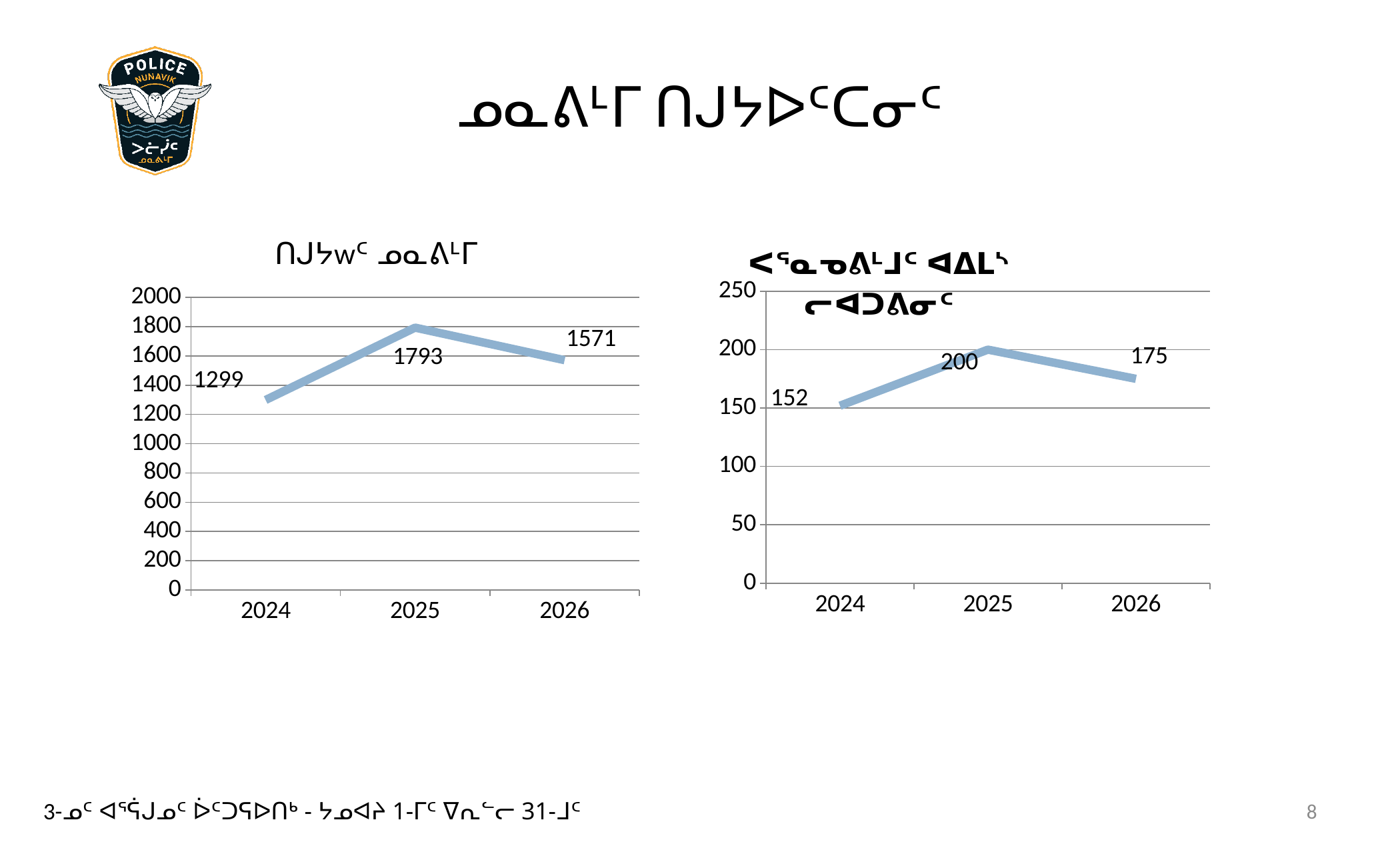
What kind of chart is the right chart? line chart On the left chart, what is the value for 2024? 1299 On the right chart, what is the value for 2024? 152 How many years are plotted on the left chart? 3 On the left chart, what is the value for 2025? 1793 On the left chart, which year has the highest value? 2025 On the right chart, which is larger, the value for 2024 or the value for 2026? 2026 On the right chart, which year has the lowest value? 2024 On the left chart, what is the difference between the values for 2025 and 2024? 494 On the right chart, what is the value for 2026? 175 On the right chart, what is the difference between the values for 2025 and 2026? 25 On the left chart, what is the value for 2026? 1571